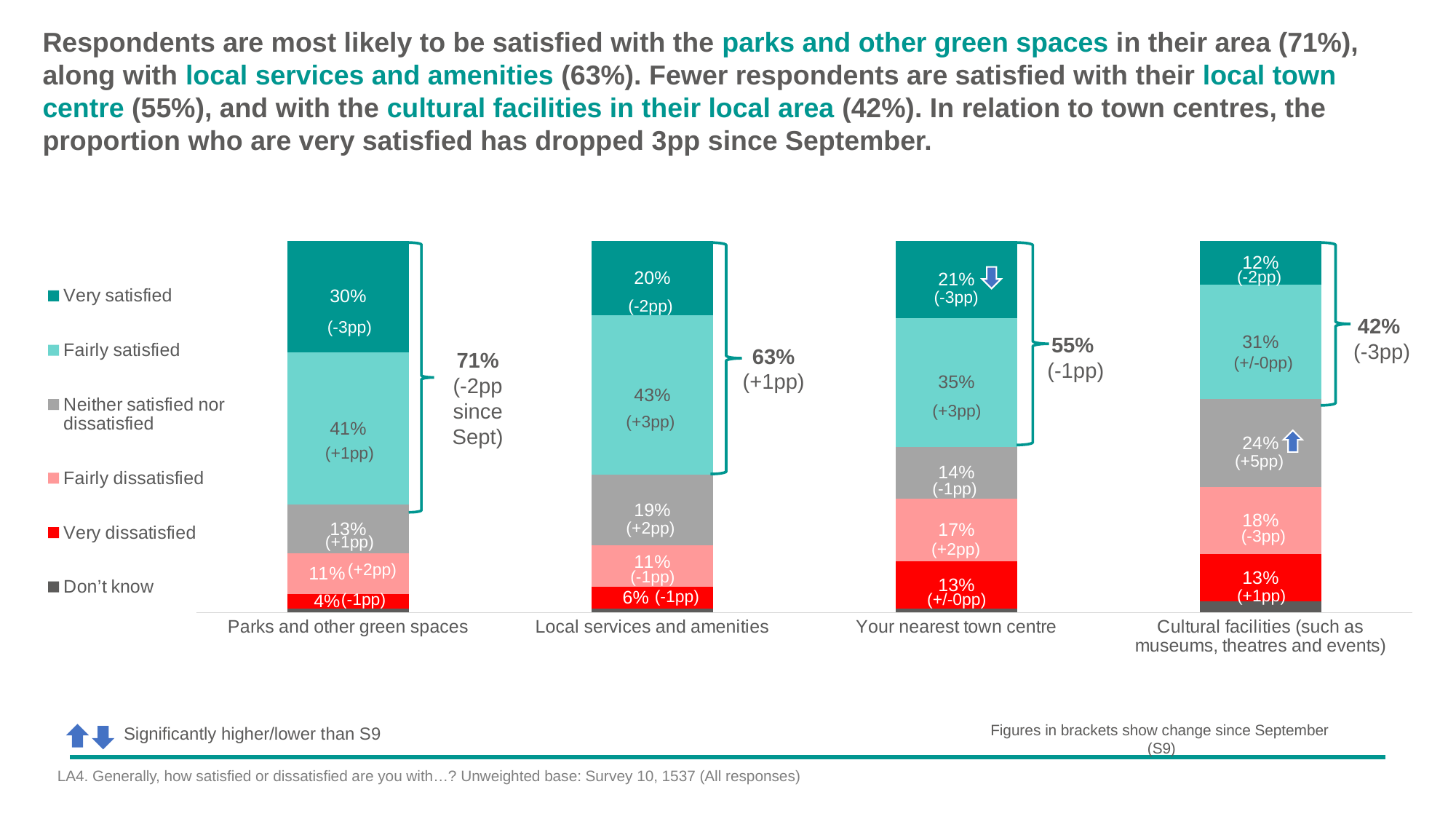
How many series does the legend list? 6 What percentage of respondents are fairly satisfied with local services and amenities? 43% What is the change since September shown for the combined satisfied percentage for your nearest town centre? -1pp What percentage of respondents are very dissatisfied with their nearest town centre? 13% What percentage of respondents are neither satisfied nor dissatisfied with cultural facilities? 24% Which is larger: the fairly dissatisfied percentage for your nearest town centre or for local services and amenities? Your nearest town centre How many categories are shown on the x axis? 4 What kind of chart is shown on the slide? Stacked bar chart Which category has the highest combined satisfied percentage? Parks and other green spaces What is the difference between the combined satisfied percentage for parks and other green spaces and for cultural facilities? 29 percentage points Which category has the lowest very satisfied percentage? Cultural facilities (such as museums, theatres and events) What percentage of respondents are very satisfied with parks and other green spaces? 30%